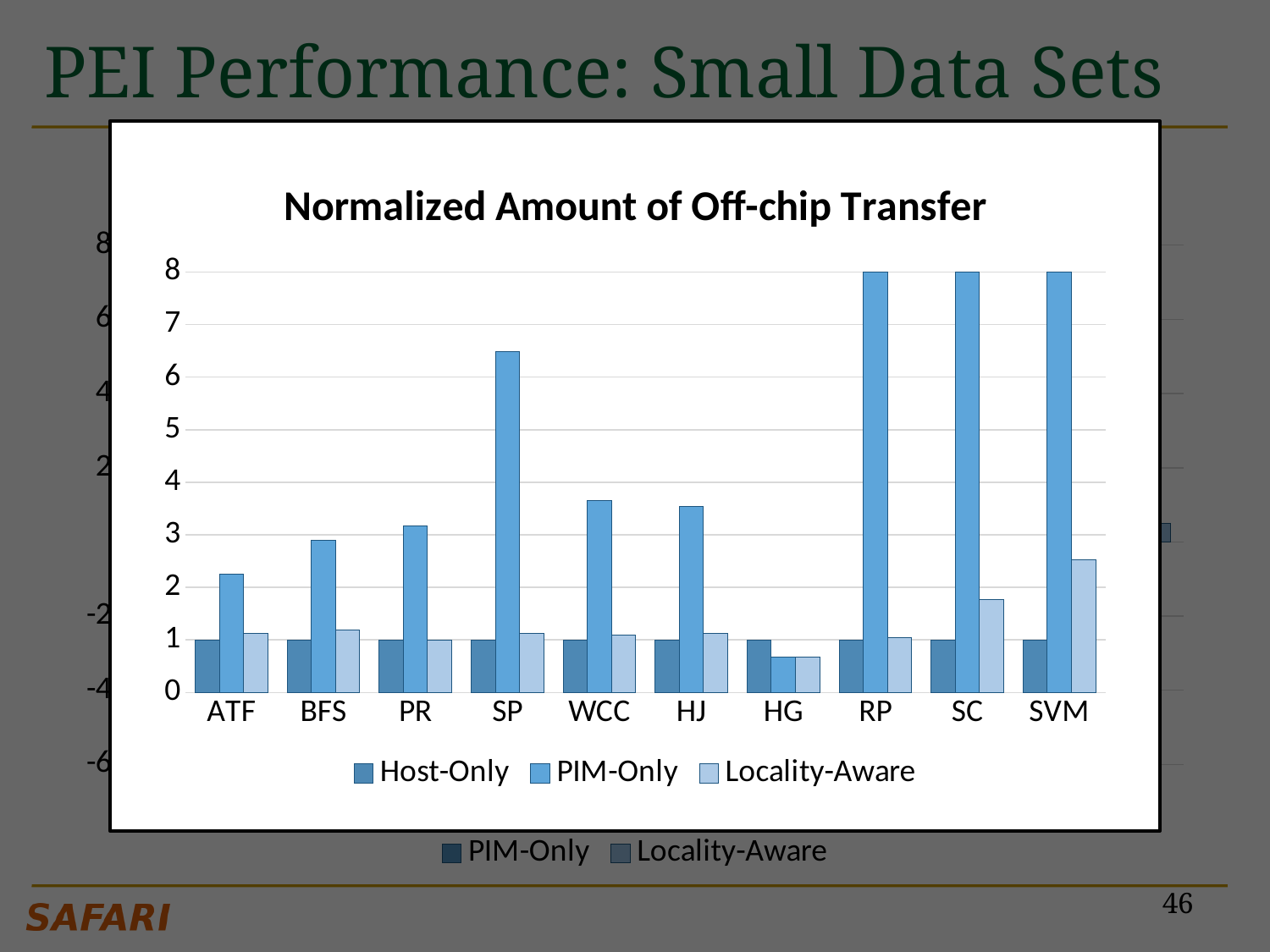
What is the title of the chart? Normalized Amount of Off-chip Transfer Is the PIM-Only value for ATF greater or less than 3? less What kind of chart is shown on the slide? bar chart What is the Host-Only value for ATF? 1 How many series does the chart's legend list? 3 Is the Locality-Aware value for SVM greater or less than 2? greater Which category has the highest Locality-Aware value? SVM Is the Locality-Aware value for HG greater or less than 1? less How many categories are shown on the x axis of the chart? 10 Which is larger, the PIM-Only value for SP or the PIM-Only value for WCC? SP Which category has the lowest PIM-Only value? HG